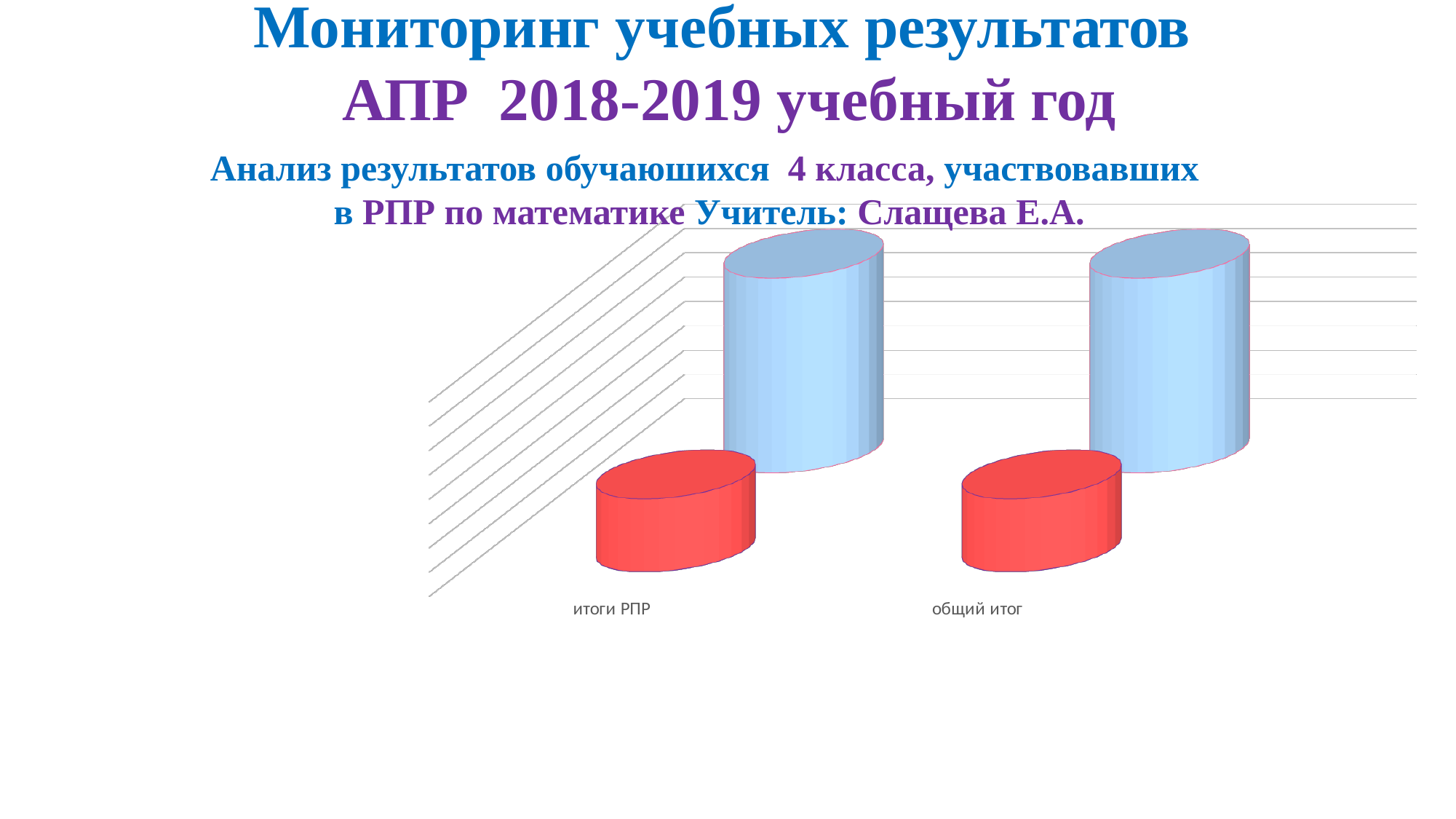
How many categories are shown on the x axis of the chart? 2 How many bars are plotted for each category in the chart? 2 What kind of chart is shown on the slide? bar chart For the category "общий итог", which bar is taller, the red one or the blue one? the blue one Which category is shown on the left of the x axis? итоги РПР What are the two category labels on the x axis of the chart? итоги РПР, общий итог What colour are the shorter bars in the chart? red For the category "итоги РПР", which bar is taller, the red one or the blue one? the blue one